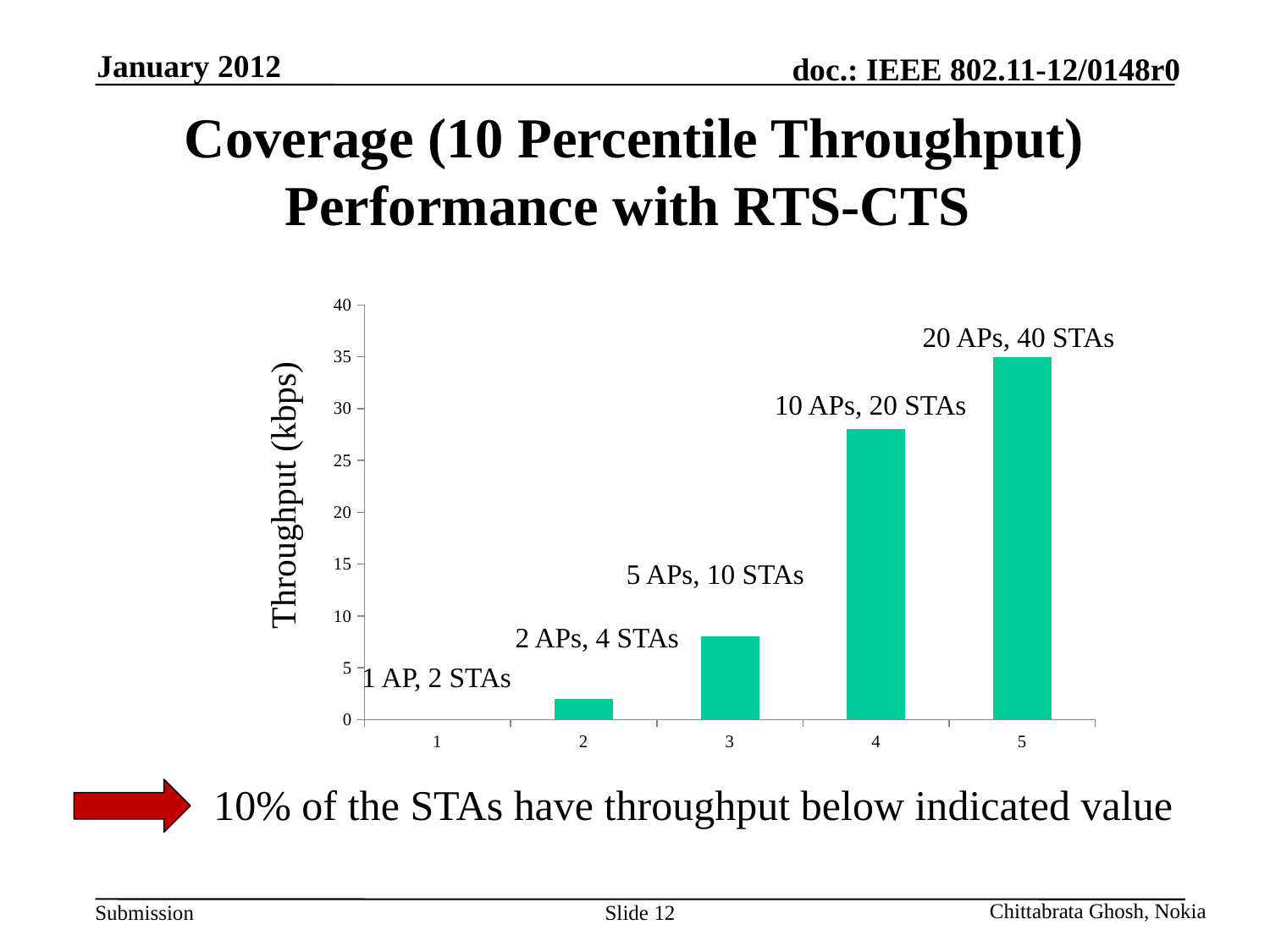
Is the throughput for 10 APs, 20 STAs greater or less than 25 kbps? greater Is the throughput for 2 APs, 4 STAs greater or less than 5 kbps? less Which has the larger throughput: 5 APs, 10 STAs or 10 APs, 20 STAs? 10 APs, 20 STAs Is the throughput for 20 APs, 40 STAs greater or less than 30 kbps? greater Which configuration has the highest throughput in the chart? 20 APs, 40 STAs What is the label of the vertical axis of the chart? Throughput (kbps) How many bars are plotted in the chart? 5 Which configuration has the lowest throughput in the chart? 1 AP, 2 STAs Do the throughput values rise or fall as the number of APs and STAs increases along the x axis? rise What kind of chart is shown on the slide? bar chart